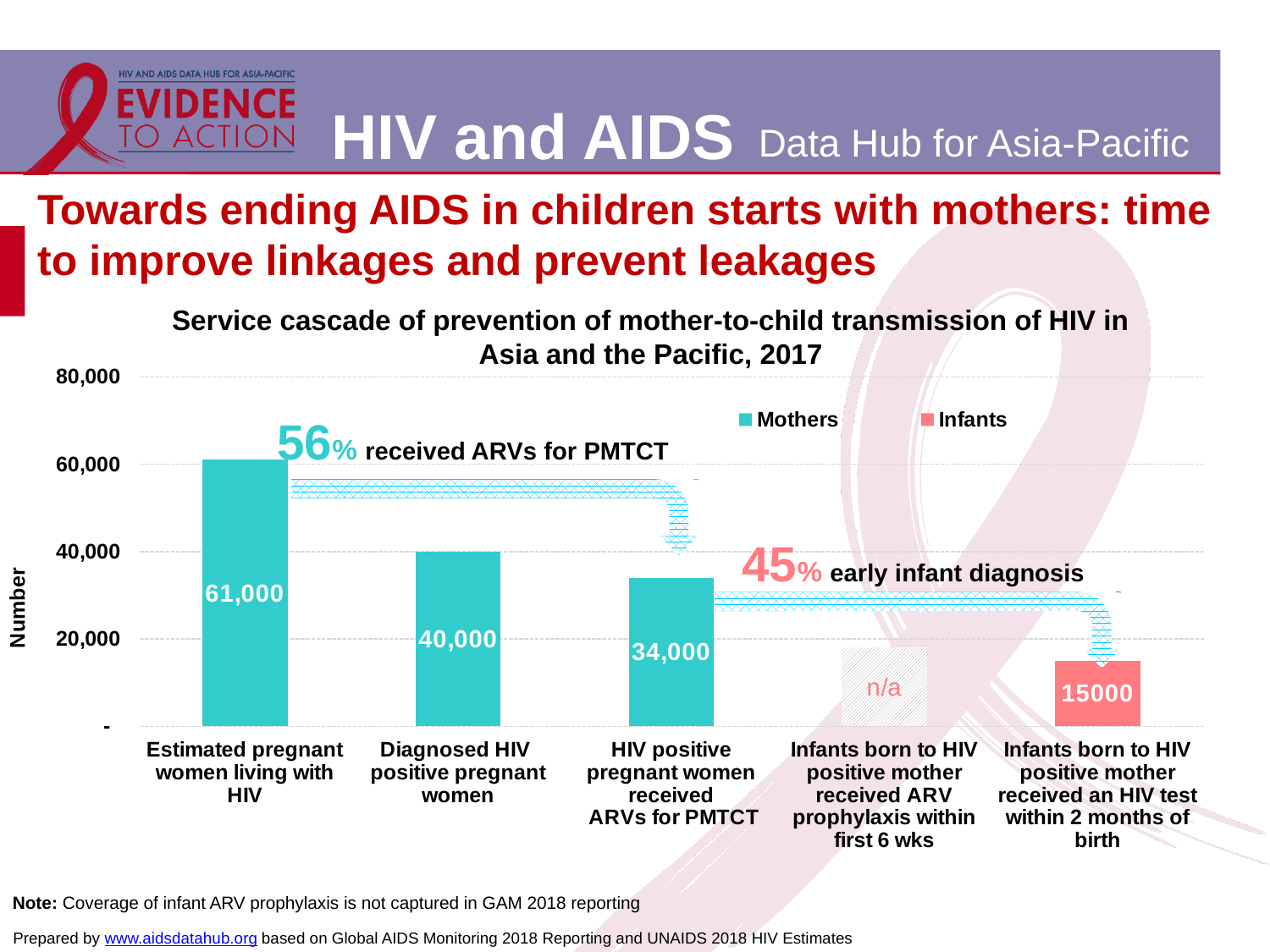
What is the value for HIV positive pregnant women received ARVs for PMTCT? 34,000 What is the value for Estimated pregnant women living with HIV? 61,000 What is the value for Infants born to HIV positive mother received an HIV test within 2 months of birth? 15000 What is the difference between Estimated pregnant women living with HIV and Diagnosed HIV positive pregnant women? 21,000 What is shown for Infants born to HIV positive mother received ARV prophylaxis within first 6 wks? n/a How many categories are shown on the x axis? 5 What is the value for Diagnosed HIV positive pregnant women? 40,000 Which category has the highest value? Estimated pregnant women living with HIV What percentage of women received ARVs for PMTCT according to the annotation on the chart? 56% What kind of chart is this? Bar chart Which is larger: Diagnosed HIV positive pregnant women or HIV positive pregnant women received ARVs for PMTCT? Diagnosed HIV positive pregnant women How many series does the legend list? 2